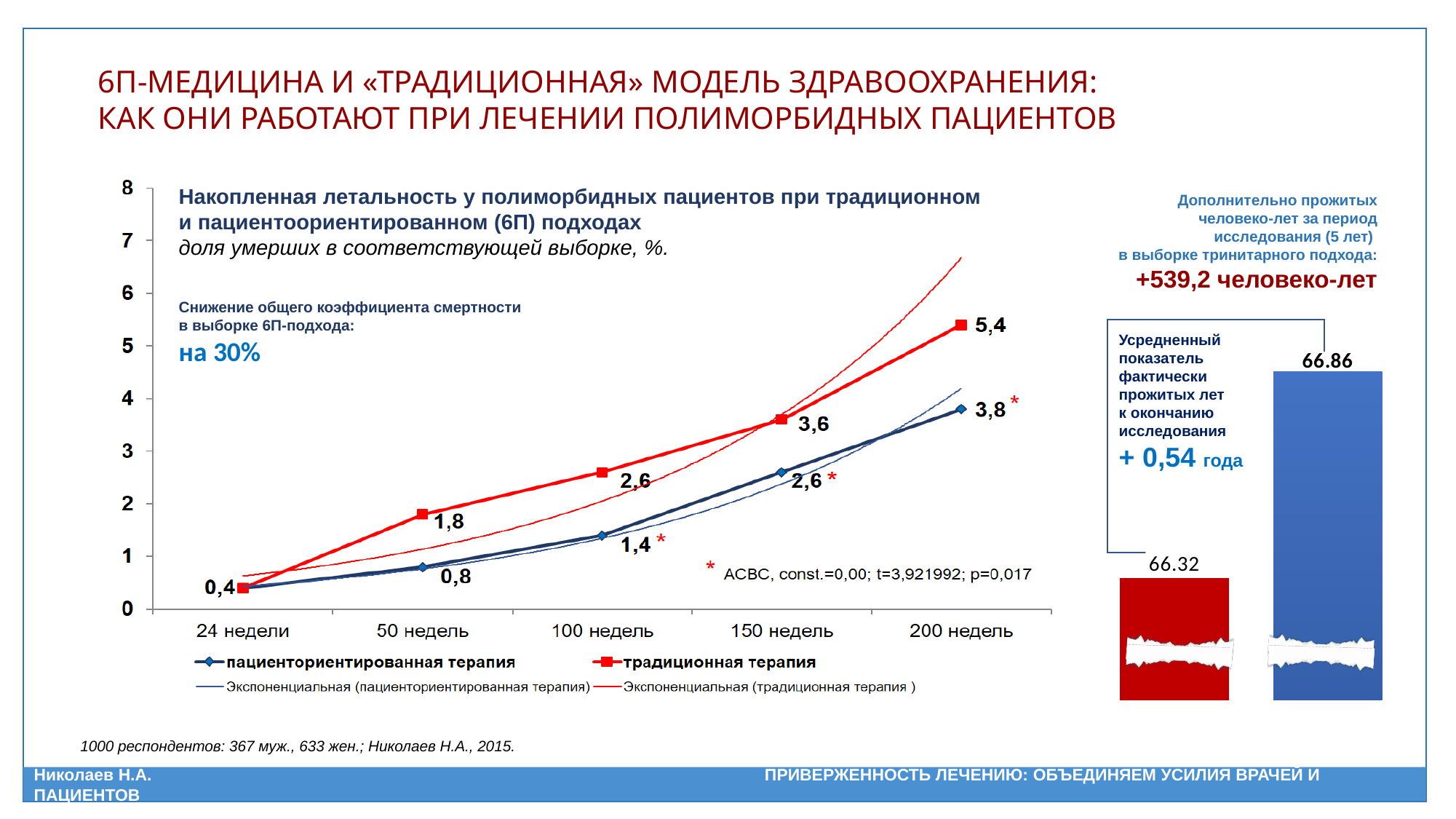
On the small bar chart on the right of the slide, what is the value of the taller blue bar? 66.86 On the line chart of cumulative mortality, what is the value for традиционная терапия at 200 недель? 5,4 On the line chart of cumulative mortality, do the values for пациентоориентированная терапия rise or fall from 24 недели to 200 недель? rise On the line chart of cumulative mortality, what is the value for традиционная терапия at 50 недель? 1,8 On the line chart of cumulative mortality, at which x-axis point does традиционная терапия reach its highest value? 200 недель On the line chart of cumulative mortality, what is the value for пациентоориентированная терапия at 24 недели? 0,4 What kind of chart is the small chart on the right of the slide showing 66.32 and 66.86? bar chart On the line chart of cumulative mortality, what is the value for пациентоориентированная терапия at 100 недель? 1,4 On the line chart of cumulative mortality, how many x-axis points are plotted for each series? 5 On the line chart of cumulative mortality, how many entries does the legend list? 4 On the line chart of cumulative mortality, which series has the larger value at 150 недель, традиционная терапия or пациентоориентированная терапия? традиционная терапия On the line chart of cumulative mortality, what is the difference between традиционная терапия and пациентоориентированная терапия at 200 недель? 1,6